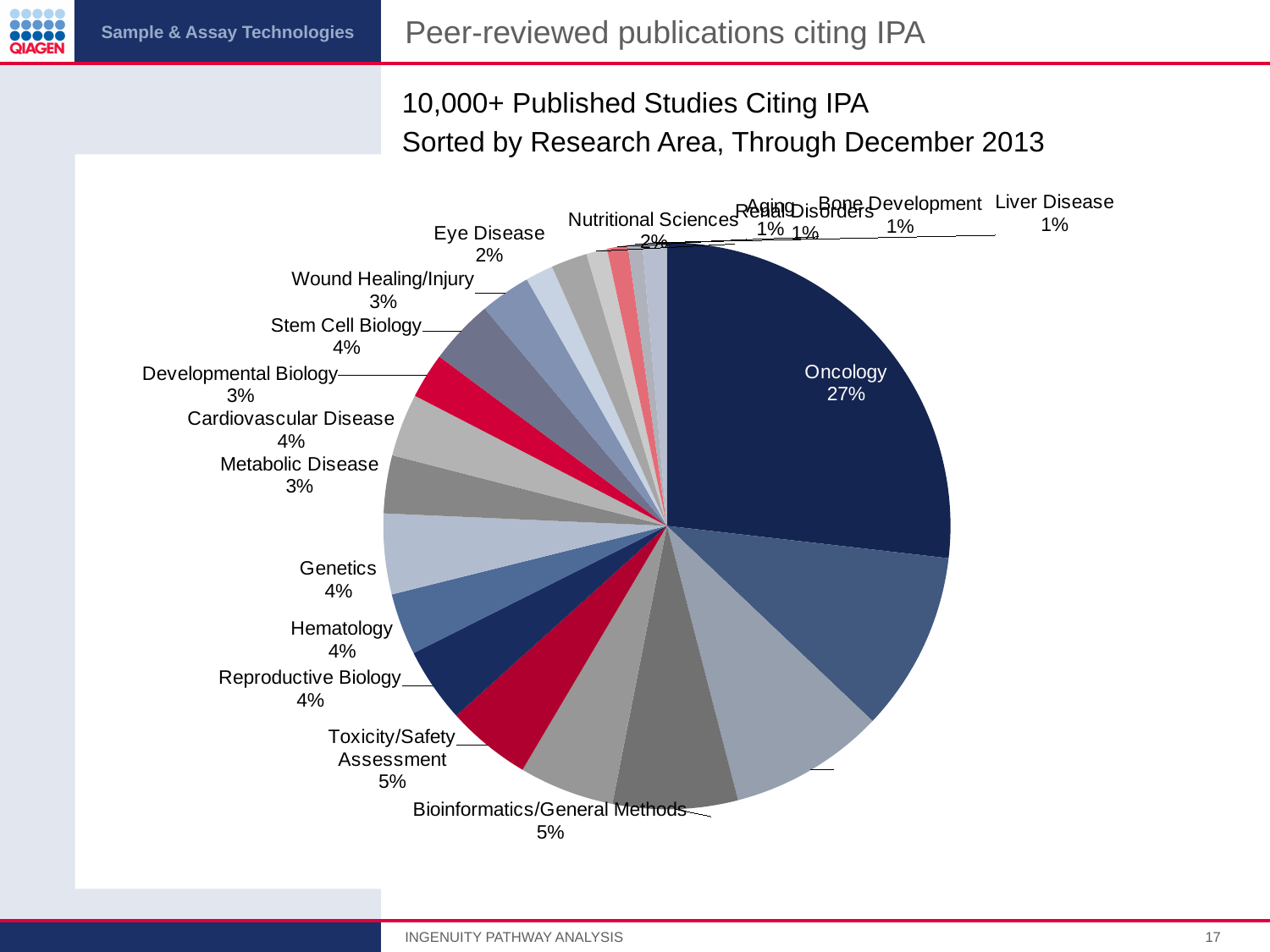
Which has a larger share, Hematology or Metabolic Disease? Hematology What percentage is shown for Liver Disease? 1% What kind of chart is shown on the slide? pie chart What percentage is shown for Eye Disease? 2% How many percentage points larger is the Oncology share than the Bioinformatics/General Methods share? 22 What percentage is shown for Wound Healing/Injury? 3% What is the title shown above the pie chart? 10,000+ Published Studies Citing IPA Sorted by Research Area, Through December 2013 What percentage is shown for Stem Cell Biology? 4% What percentage is shown for Toxicity/Safety Assessment? 5% What share of published studies citing IPA is in Oncology? 27% Which research area has the largest share of the pie? Oncology What percentage is shown for Bioinformatics/General Methods? 5%